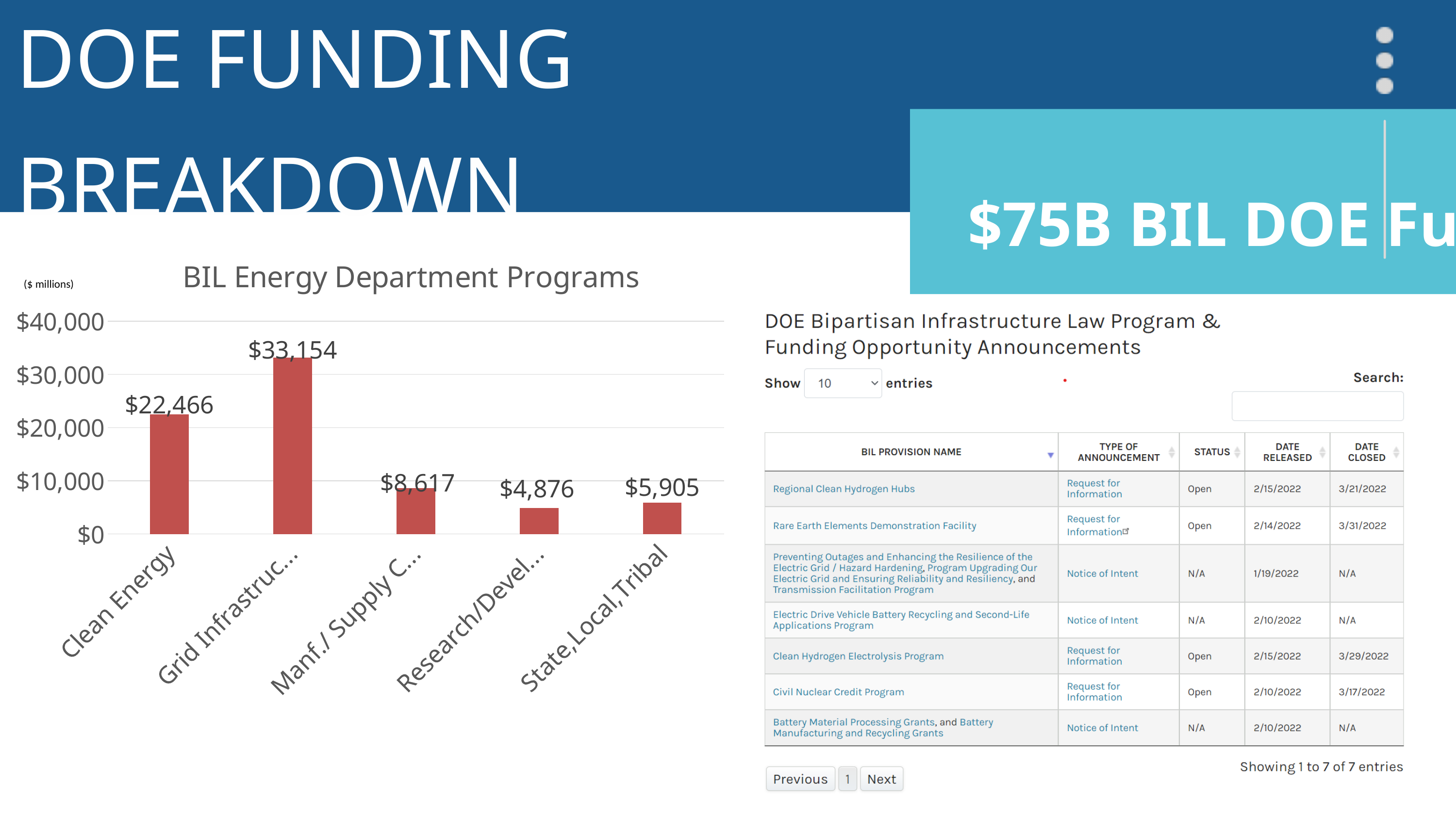
What is the value for Clean Energy in the BIL Energy Department Programs chart? $22,466 What is the difference between the Grid Infrastruc... and Clean Energy values in the BIL Energy Department Programs chart? $10,688 What is the value for State,Local,Tribal in the BIL Energy Department Programs chart? $5,905 What is the value for the Research/Devel... category in the BIL Energy Department Programs chart? $4,876 How many categories are shown in the BIL Energy Department Programs chart? 5 In the BIL Energy Department Programs chart, which is larger: Manf./ Supply C... or State,Local,Tribal? Manf./ Supply C... What is the difference between the State,Local,Tribal and Research/Devel... values in the BIL Energy Department Programs chart? $1,029 Which category has the lowest value in the BIL Energy Department Programs chart? Research/Devel... Is the value for Clean Energy in the BIL Energy Department Programs chart greater or less than $20,000? greater What type of chart is the BIL Energy Department Programs chart? bar chart Which category has the highest value in the BIL Energy Department Programs chart? Grid Infrastruc... What unit is indicated for the values in the BIL Energy Department Programs chart? $ millions